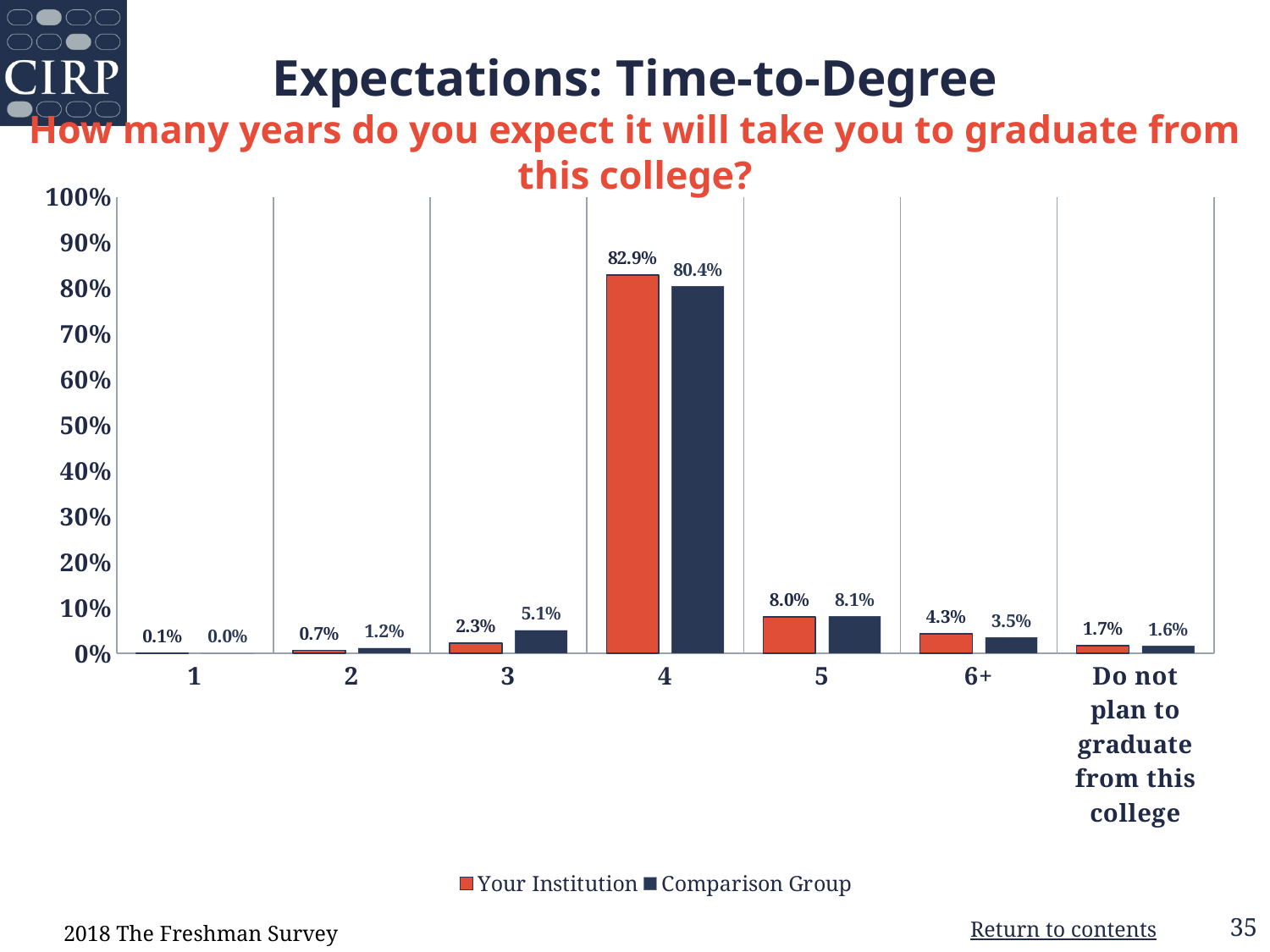
What percentage of Your Institution respondents expect to graduate in 4 years? 82.9% What is the difference between Your Institution and the Comparison Group for 4 years? 2.5% For 3 years, which is larger: Your Institution or the Comparison Group? Comparison Group For 6+ years, which is larger: Your Institution or the Comparison Group? Your Institution How many categories are shown on the x axis? 7 What is the Your Institution value for the 'Do not plan to graduate from this college' category? 1.7% Which category has the highest value for the Comparison Group? 4 What kind of chart is shown on the slide? Bar chart Which category has the lowest value for Your Institution? 1 How many series does the legend list? 2 Is the Comparison Group value for 4 years greater or less than 70%? greater What is the Comparison Group value for 3 years? 5.1%